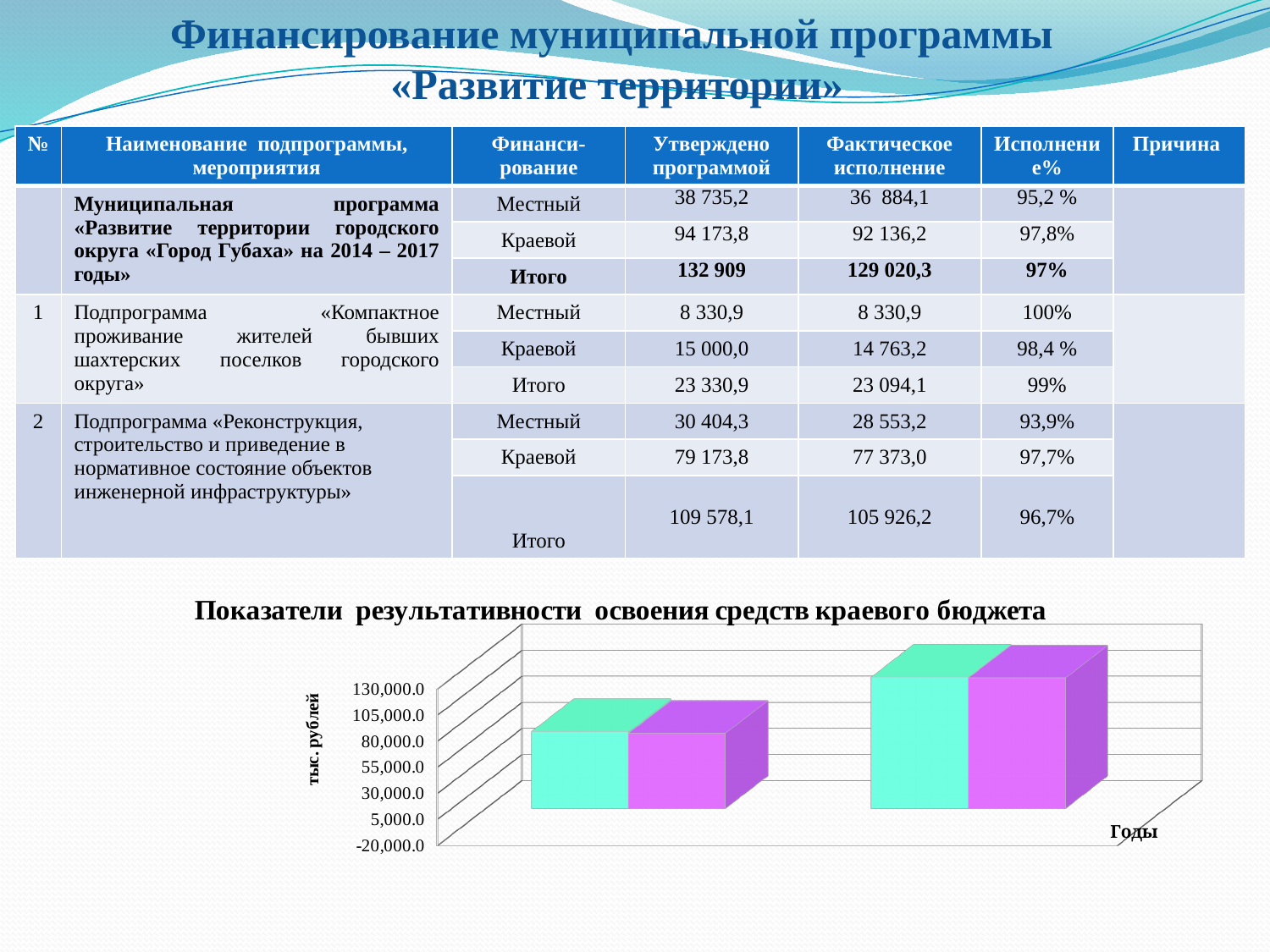
Is the value of the right purple bar in the chart greater or less than 55,000.0? greater How many groups of bars are plotted in the chart? 2 Which group of bars in the chart is taller, the left group or the right group? the right group Is the value of the left teal bar in the chart greater or less than 130,000.0? less Do the bar heights in the chart rise or fall from left to right? rise Is the value of the right teal bar in the chart greater or less than 80,000.0? greater What kind of chart is shown at the bottom of the slide? bar chart What is the title of the chart at the bottom of the slide? Показатели результативности освоения средств краевого бюджета What label is shown on the vertical axis of the chart? тыс. рублей How many bars are plotted in the chart in total? 4